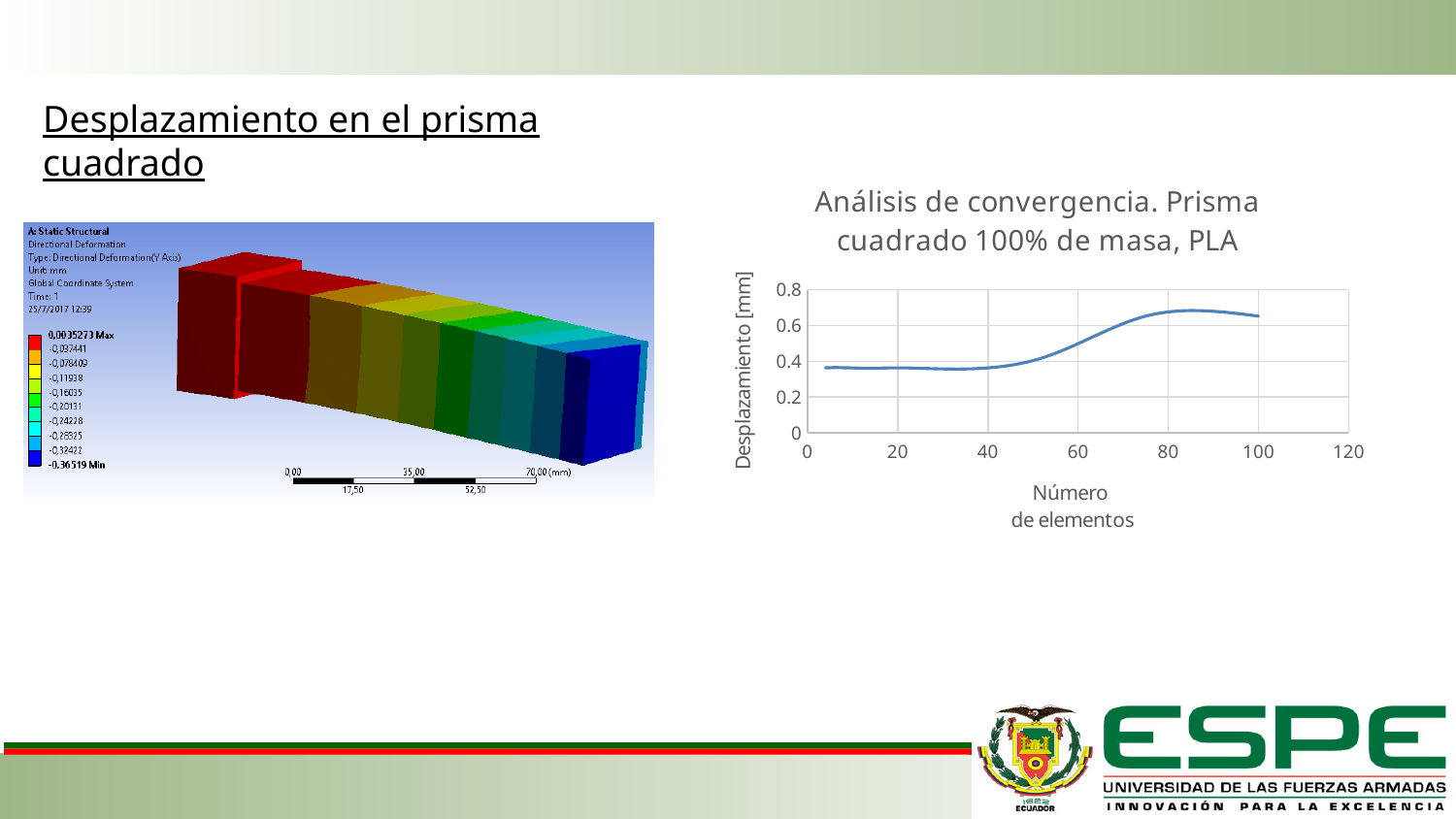
What is the title of the chart on the slide? Análisis de convergencia. Prisma cuadrado 100% de masa, PLA Is the value for 40 elements greater or less than 0.2? greater Does the displacement generally rise or fall as the number of elements increases from 40 to 80? rise Is the value for 20 elements greater or less than 0.6? less What kind of chart is shown on the slide? line chart What is the highest value shown on the horizontal axis of the chart? 120 Is the value for 80 elements greater or less than 0.6? greater What is the label of the vertical axis of the chart? Desplazamiento [mm] Which is larger, the displacement at 80 elements or at 20 elements? 80 elements